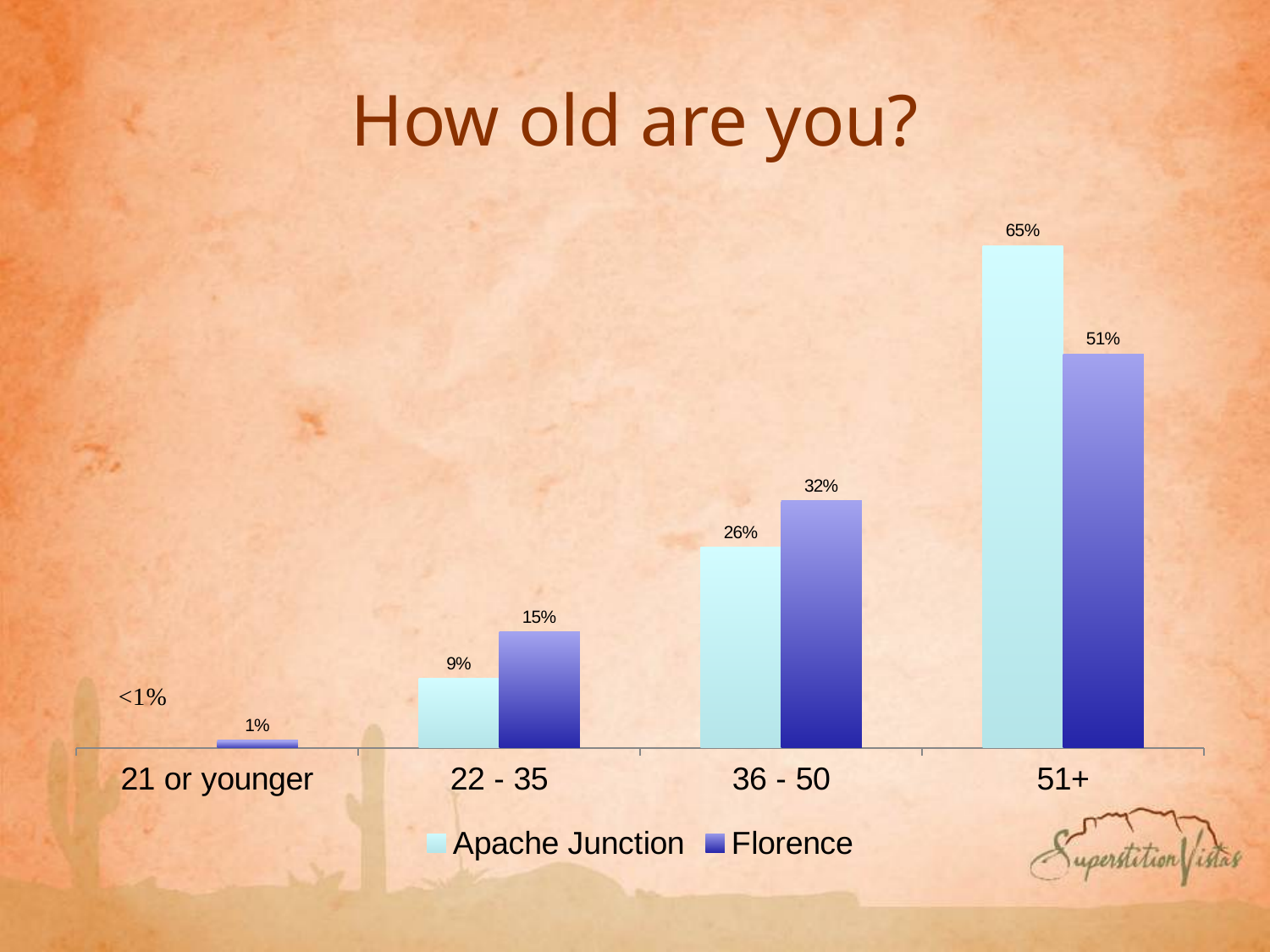
How many series does the legend list? 2 Which age group has the lowest value for Apache Junction? 21 or younger Which age group has the highest value for Florence? 51+ What kind of chart is shown on the slide? Bar chart What is the value for Florence in the 22 - 35 age group? 15% What is the value for Florence in the 21 or younger age group? 1% What is the value for Apache Junction in the 51+ age group? 65% Which is larger in the 36 - 50 age group, Apache Junction or Florence? Florence How many age groups are shown on the x axis? 4 Do the Florence values rise or fall from the 21 or younger group to the 51+ group? Rise What is the difference between Apache Junction and Florence in the 51+ age group? 14% What is the value for Apache Junction in the 36 - 50 age group? 26%